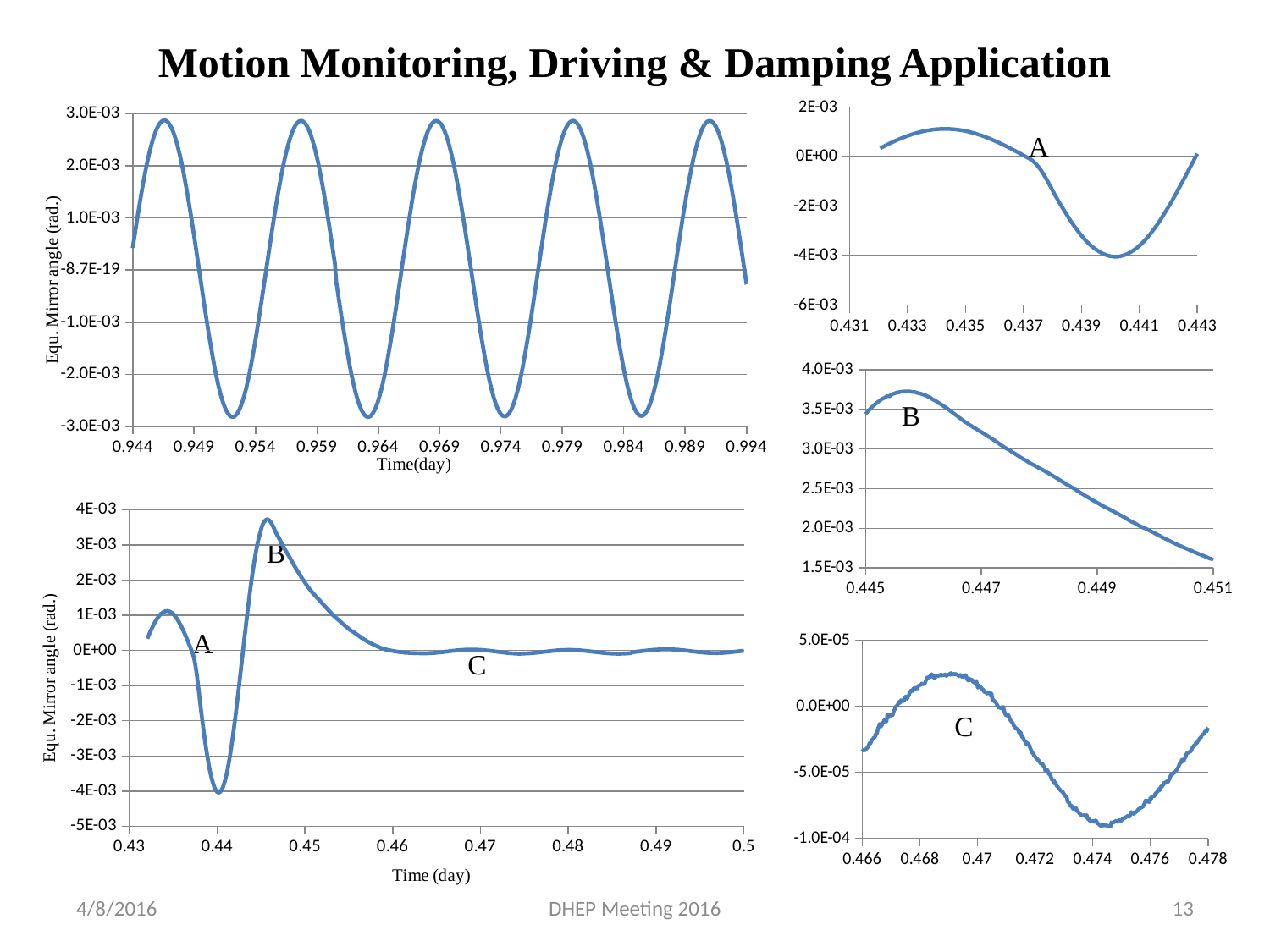
In the bottom-left chart, is the peak value at point B greater or less than 3E-03? greater In the bottom-left chart, is the minimum value of the curve near 0.44 greater or less than -3E-03? less How many labelled points (letters) are marked on the bottom-left chart? 3 In the top-left chart, is the peak value of the curve greater or less than 2.0E-03? greater How many charts are shown on the slide? 5 What is the y-axis label of the bottom-left chart? Equ. Mirror angle (rad.) In the middle-right chart (labelled B), do the values rise or fall along the x axis from 0.447 to 0.451? fall What is the x-axis label of the top-left chart? Time(day) What kind of chart is the top-left chart on the slide? line chart How many full peaks does the curve in the top-left chart show? 5